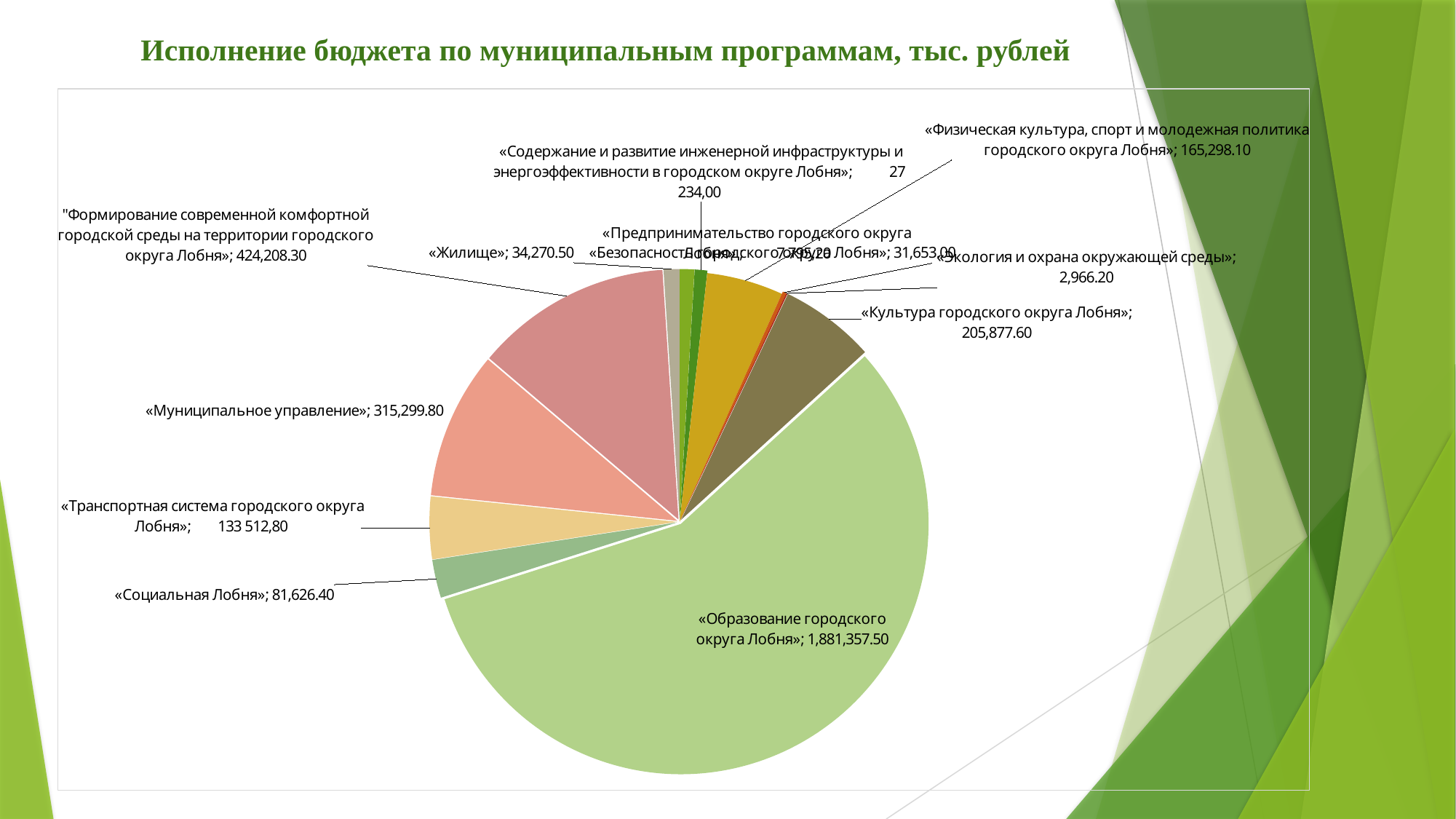
What is the value for «Социальная Лобня»? 81,626.40 Which program has the smallest value shown? «Экология и охрана окружающей среды» What is the title of the chart? Исполнение бюджета по муниципальным программам, тыс. рублей Which program has the largest slice of the pie? «Образование городского округа Лобня» What is the value for «Образование городского округа Лобня»? 1,881,357.50 What is the value for «Культура городского округа Лобня»? 205,877.60 What is the value for «Муниципальное управление»? 315,299.80 What is the value for «Экология и охрана окружающей среды»? 2,966.20 What is the difference between the values for «Формирование современной комфортной городской среды на территории городского округа Лобня» and «Муниципальное управление»? 108,908.50 Which is larger: «Муниципальное управление» or «Культура городского округа Лобня»? «Муниципальное управление» What kind of chart is shown on the slide? pie chart What is the value for «Жилище»? 34,270.50